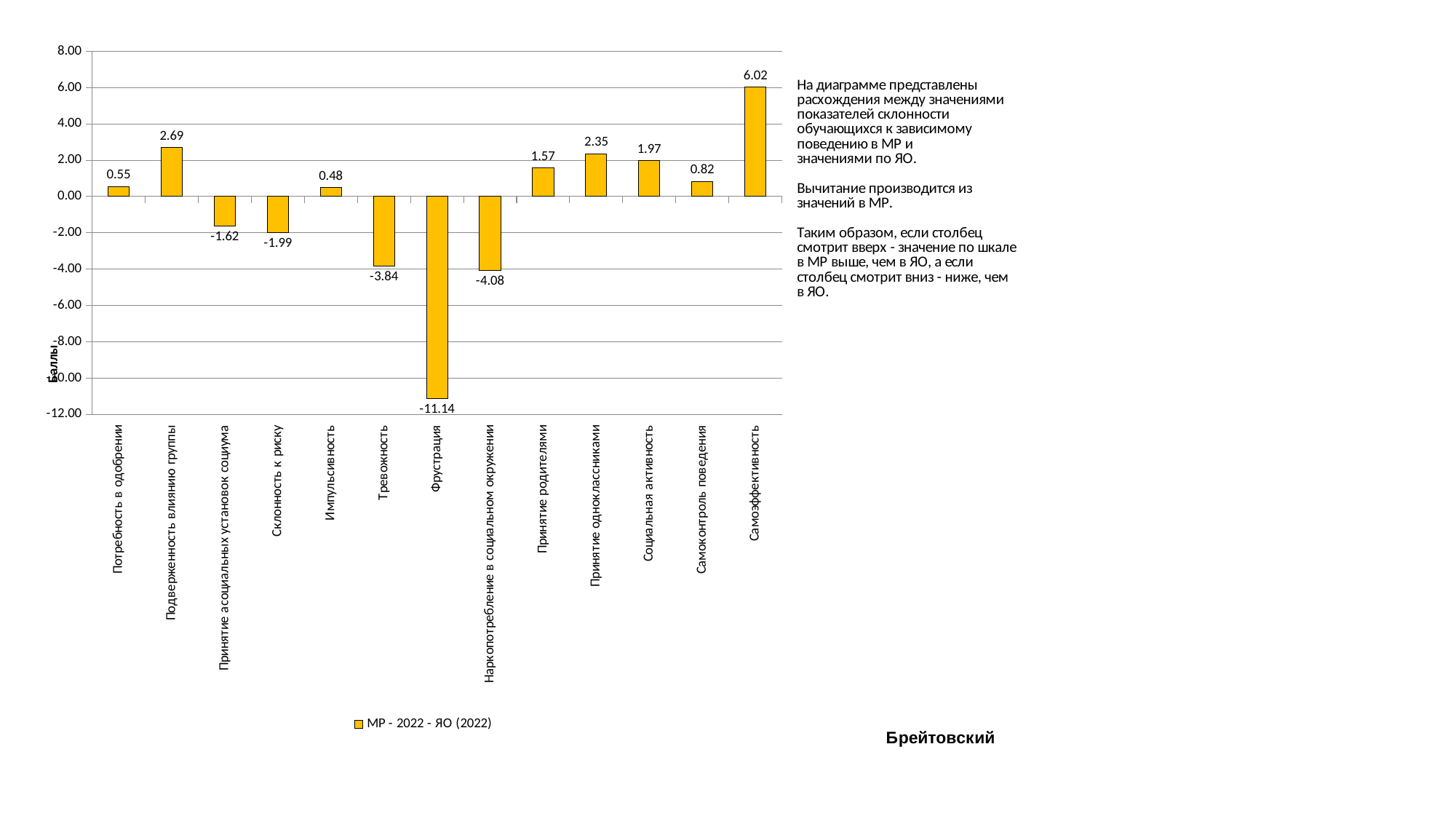
What is the value for Принятие одноклассниками? 2.35 What is the value for Самоэффективность? 6.02 What series name does the legend show? МР - 2022 - ЯО (2022) How many categories are shown on the x axis? 13 Which is larger, the value for Принятие родителями or the value for Самоконтроль поведения? Принятие родителями What is the difference between the values for Подверженность влиянию группы and Социальная активность? 0.72 Which category has the lowest value? Фрустрация What kind of chart is shown on the slide? bar chart What is the value for Наркопотребление в социальном окружении? -4.08 Is the value for Тревожность greater or less than -2.00? less Which category has the highest value? Самоэффективность What is the value for Фрустрация? -11.14